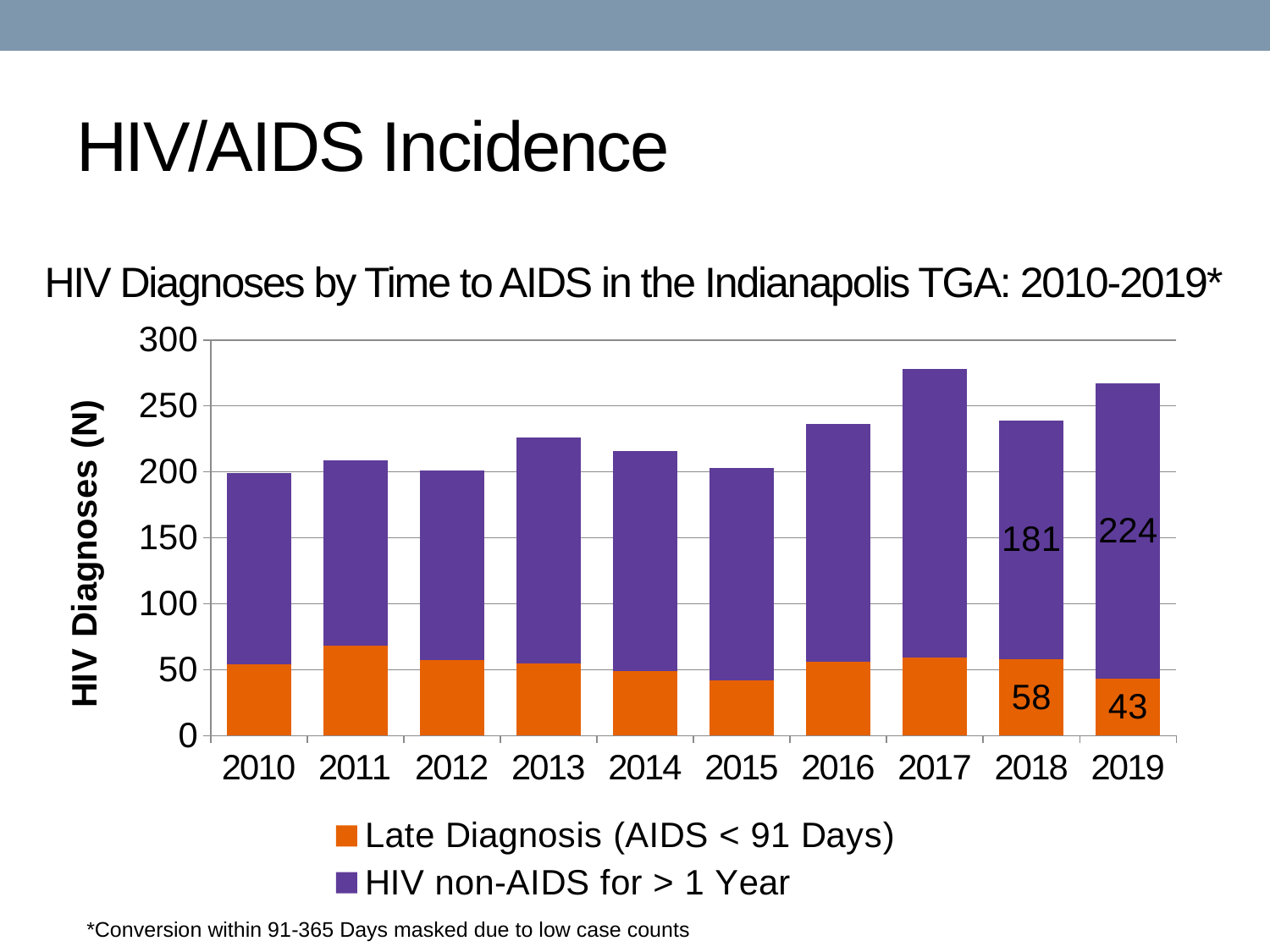
How many series does the legend list? 2 What is the total height of the stacked bar for 2018? 239 What is the total height of the stacked bar for 2019? 267 What kind of chart is shown on the slide? Stacked bar chart What is the value for HIV non-AIDS for > 1 Year in 2018? 181 Is the total value for 2013 greater or less than 200? greater What is the value for HIV non-AIDS for > 1 Year in 2019? 224 What is the difference between the HIV non-AIDS for > 1 Year values in 2019 and 2018? 43 What is the value for Late Diagnosis (AIDS < 91 Days) in 2019? 43 What is the value for Late Diagnosis (AIDS < 91 Days) in 2018? 58 How many years are shown on the x axis? 10 Which year has the taller stacked bar overall, 2017 or 2019? 2017